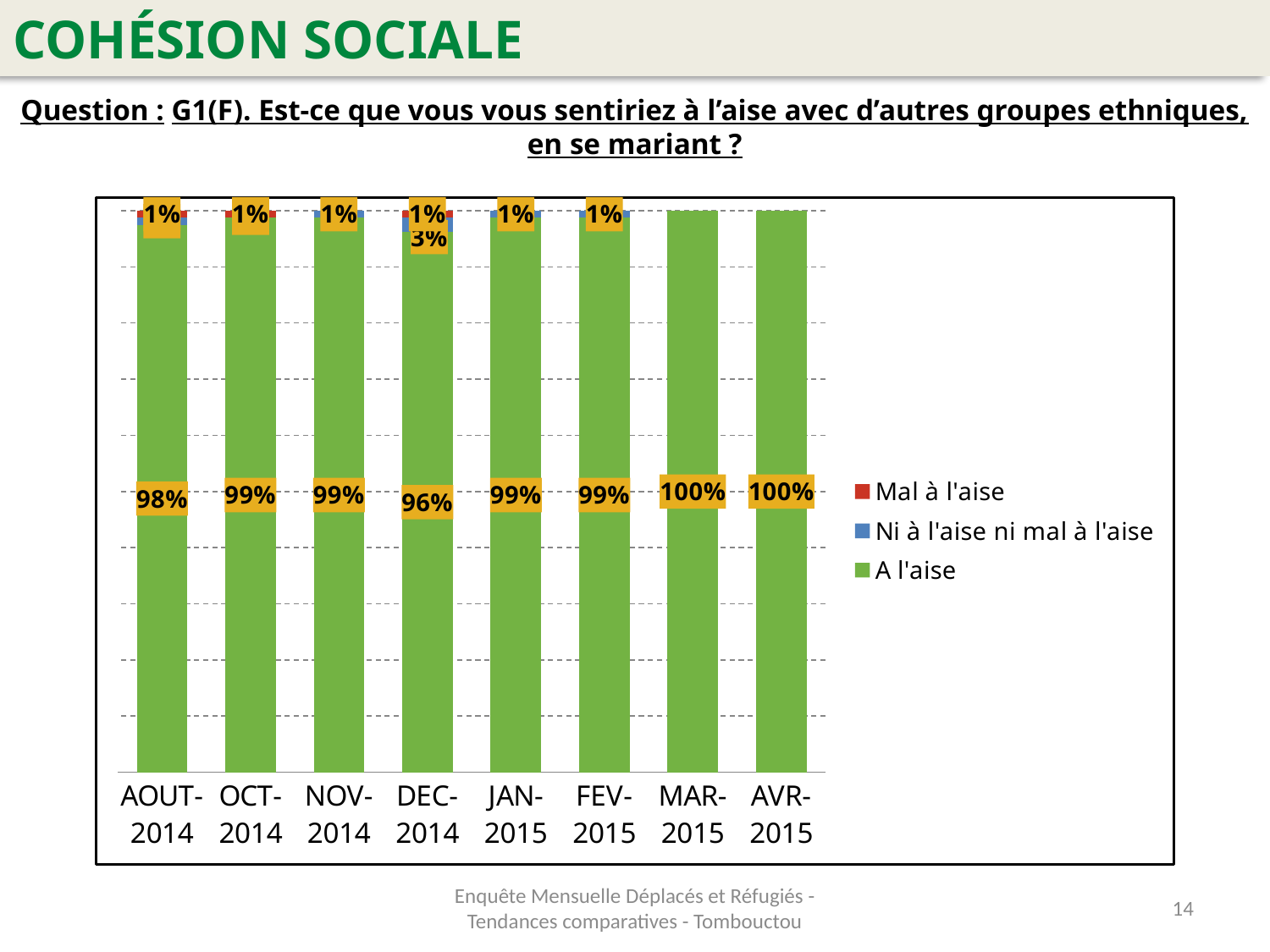
What is the value for "A l'aise" in MAR-2015? 100% In which month is the "A l'aise" share lowest? DEC-2014 How many series does the legend list? 3 What colour represents the "A l'aise" series? Green How many months are shown on the x axis? 8 How many months show an "A l'aise" value of 100%? 2 What kind of chart is shown on the slide? Stacked bar chart What is the value for "A l'aise" in AOUT-2014? 98% What is the difference between the "A l'aise" values for OCT-2014 and DEC-2014? 3 percentage points What is the value for "A l'aise" in DEC-2014? 96% Does the "A l'aise" share rise or fall from DEC-2014 to AVR-2015? Rise Which month has the larger "A l'aise" value, AOUT-2014 or OCT-2014? OCT-2014